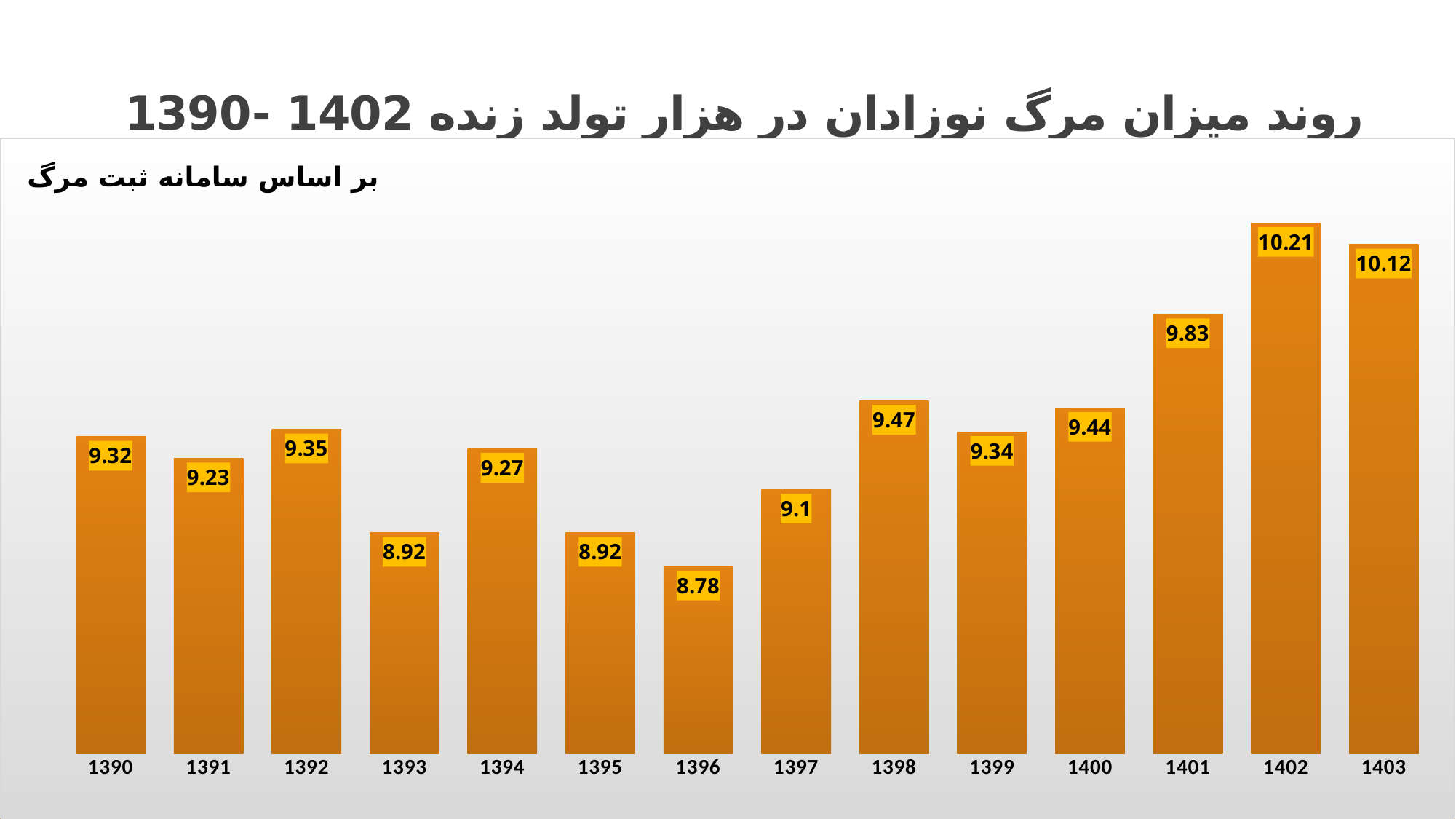
Which year has the lowest value? 1396 Which year has the highest value? 1402 Which is larger, the value for 1397 or the value for 1399? 1399 What is the value for 1402? 10.21 What is the value for 1398? 9.47 What is the difference between the values for 1401 and 1396? 1.05 What is the value for 1396? 8.78 Do the values generally rise or fall from 1399 to 1402? rise Which is larger, the value for 1390 or the value for 1391? 1390 How many years are shown on the x axis? 14 What kind of chart is shown on the slide? bar chart What is the difference between the values for 1402 and 1403? 0.09